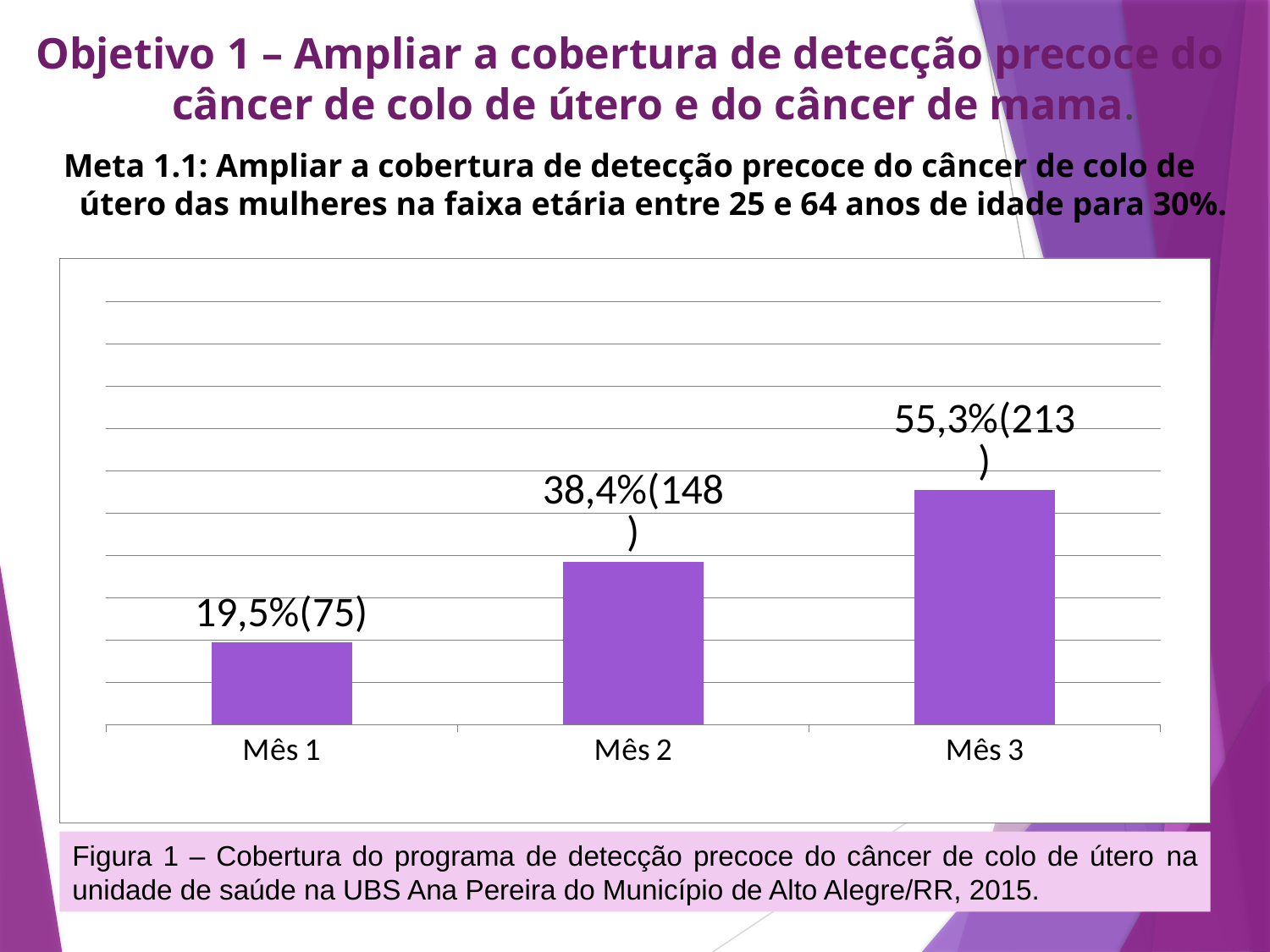
What kind of chart is shown on the slide? Bar chart How many months (categories) are plotted on the chart? 3 How many women are shown in parentheses for Mês 3? 213 Which month has the highest bar? Mês 3 What is the difference in percentage points between Mês 3 and Mês 1? 35,8 What is the data label shown for Mês 3? 55,3%(213) What coverage percentage is shown for Mês 2? 38,4% What is the data label shown for Mês 2? 38,4%(148) Which is larger, the value for Mês 2 or the value for Mês 1? Mês 2 Which month has the lowest bar? Mês 1 What is the data label shown for Mês 1? 19,5%(75) What is the difference between the number in parentheses for Mês 2 and for Mês 1? 73